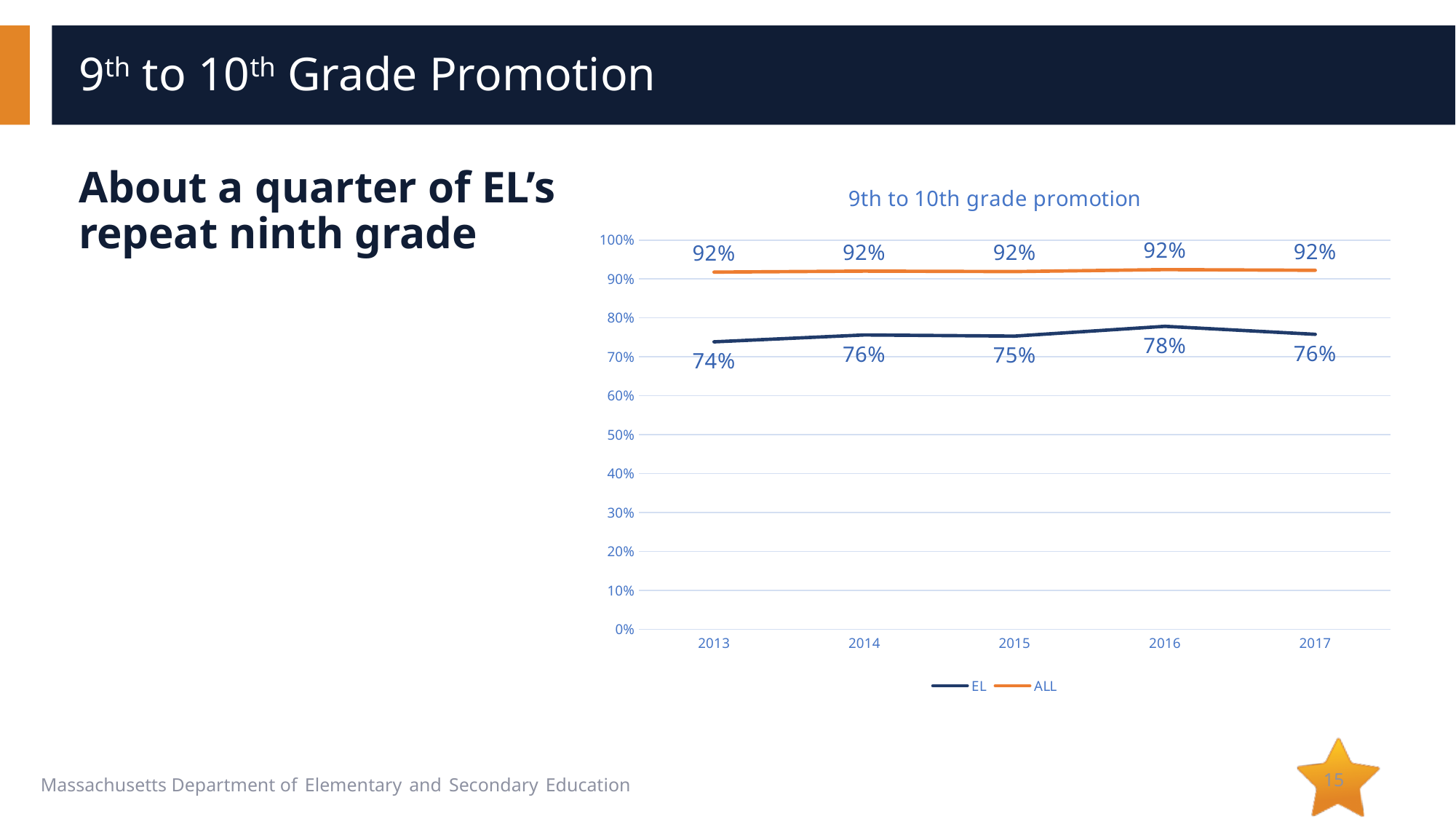
How many years are shown on the x axis? 5 What is the difference between the ALL and EL promotion rates in 2017? 16% In which year is the EL promotion rate lowest? 2013 What is the EL promotion rate in 2016? 78% What is the ALL promotion rate in 2015? 92% What kind of chart is shown on the slide? line chart What is the EL promotion rate in 2013? 74% In which year is the EL promotion rate highest? 2016 Is the EL promotion rate in 2015 greater or less than 80%? less What is the title of the chart? 9th to 10th grade promotion Which series has the higher promotion rate in 2014, EL or ALL? ALL How many series does the legend list? 2